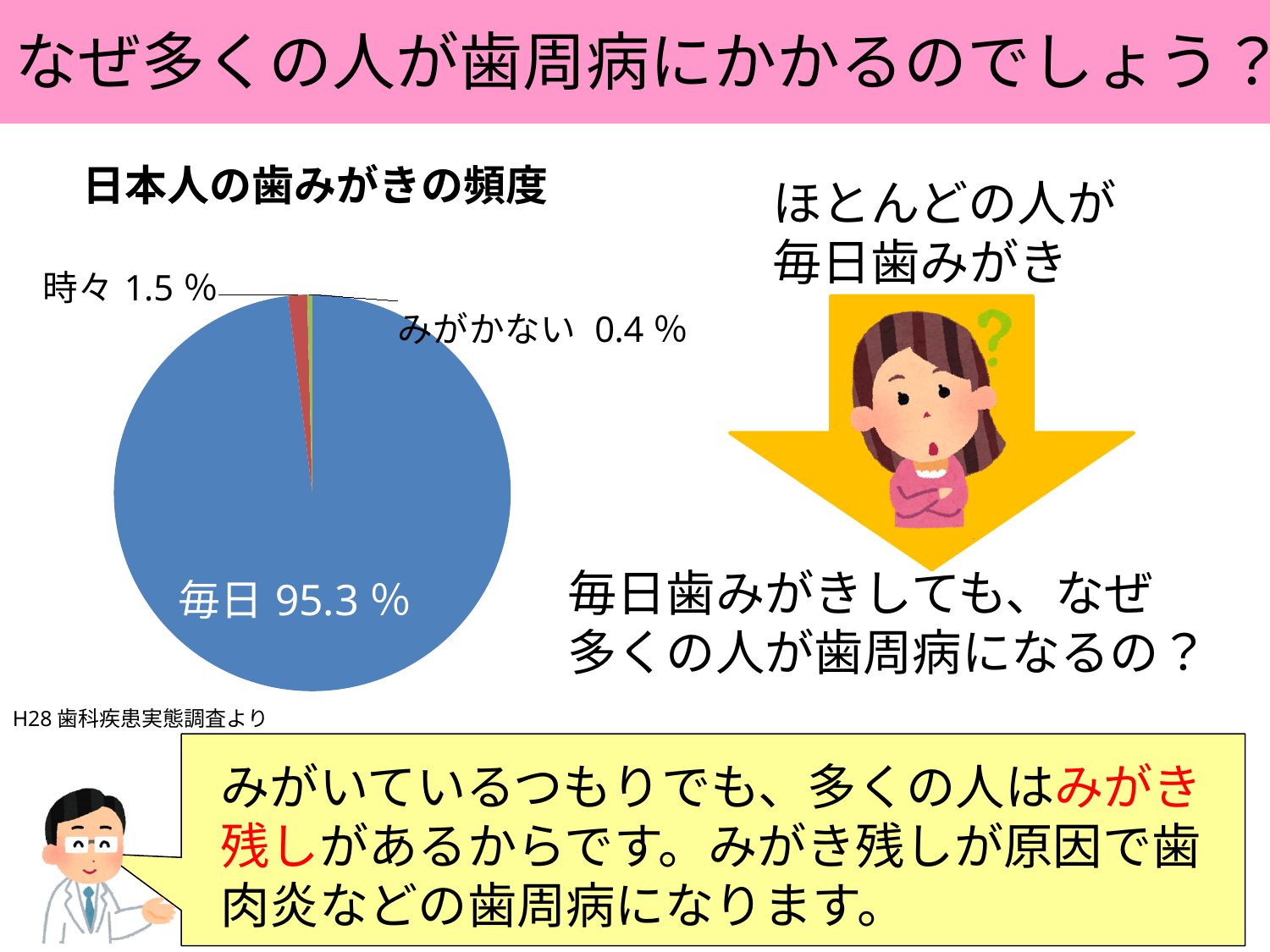
What is the title of the pie chart? 日本人の歯みがきの頻度 What is the difference in percentage points between 時々 and みがかない? 1.1 Which category has the largest slice in the pie chart? 毎日 What percentage of the pie chart is labelled みがかない? 0.4 % What source is cited below the pie chart? H28 歯科疾患実態調査より What percentage of the pie chart is labelled 時々? 1.5 % Which category has the smallest slice in the pie chart? みがかない What type of chart is shown on the slide? Pie chart Which is larger in the pie chart, 時々 or みがかない? 時々 What percentage of the pie chart is labelled 毎日? 95.3 % What is the difference in percentage points between 毎日 and 時々? 93.8 How many categories are shown in the pie chart? 3